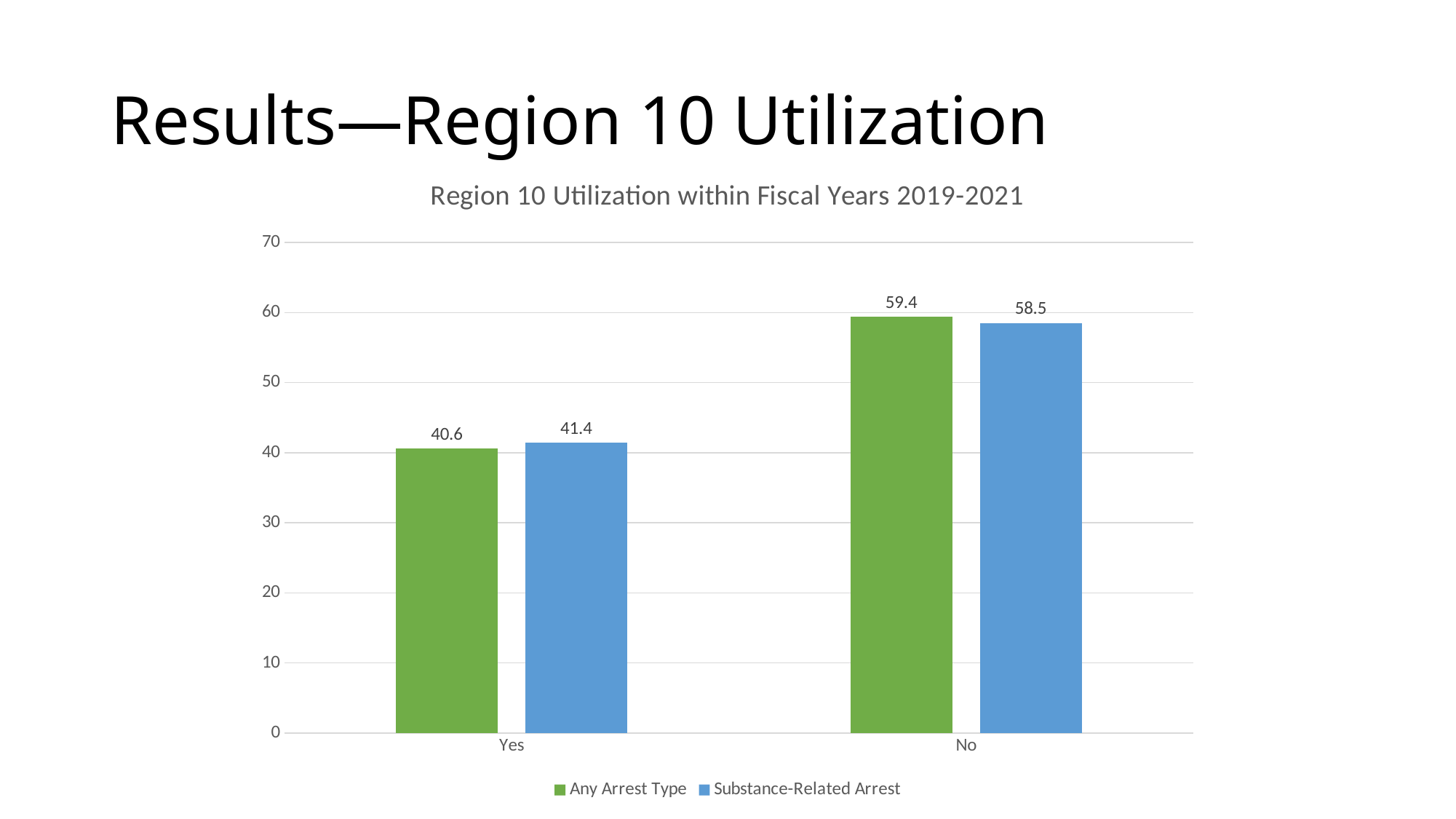
How many categories are shown on the x axis? 2 What kind of chart is shown on the slide? Bar chart What is the value for Substance-Related Arrest in the Yes category? 41.4 What is the value for Substance-Related Arrest in the No category? 58.5 Which category has the lowest value for Substance-Related Arrest? Yes Which is larger: Any Arrest Type for Yes or Any Arrest Type for No? Any Arrest Type for No What is the difference between the Any Arrest Type values for No and Yes? 18.8 How many series does the legend list? 2 What is the difference between the Any Arrest Type and Substance-Related Arrest values in the No category? 0.9 Is the value for Substance-Related Arrest in the No category greater or less than 50? greater What is the value for Any Arrest Type in the Yes category? 40.6 Which category has the highest value for Any Arrest Type? No